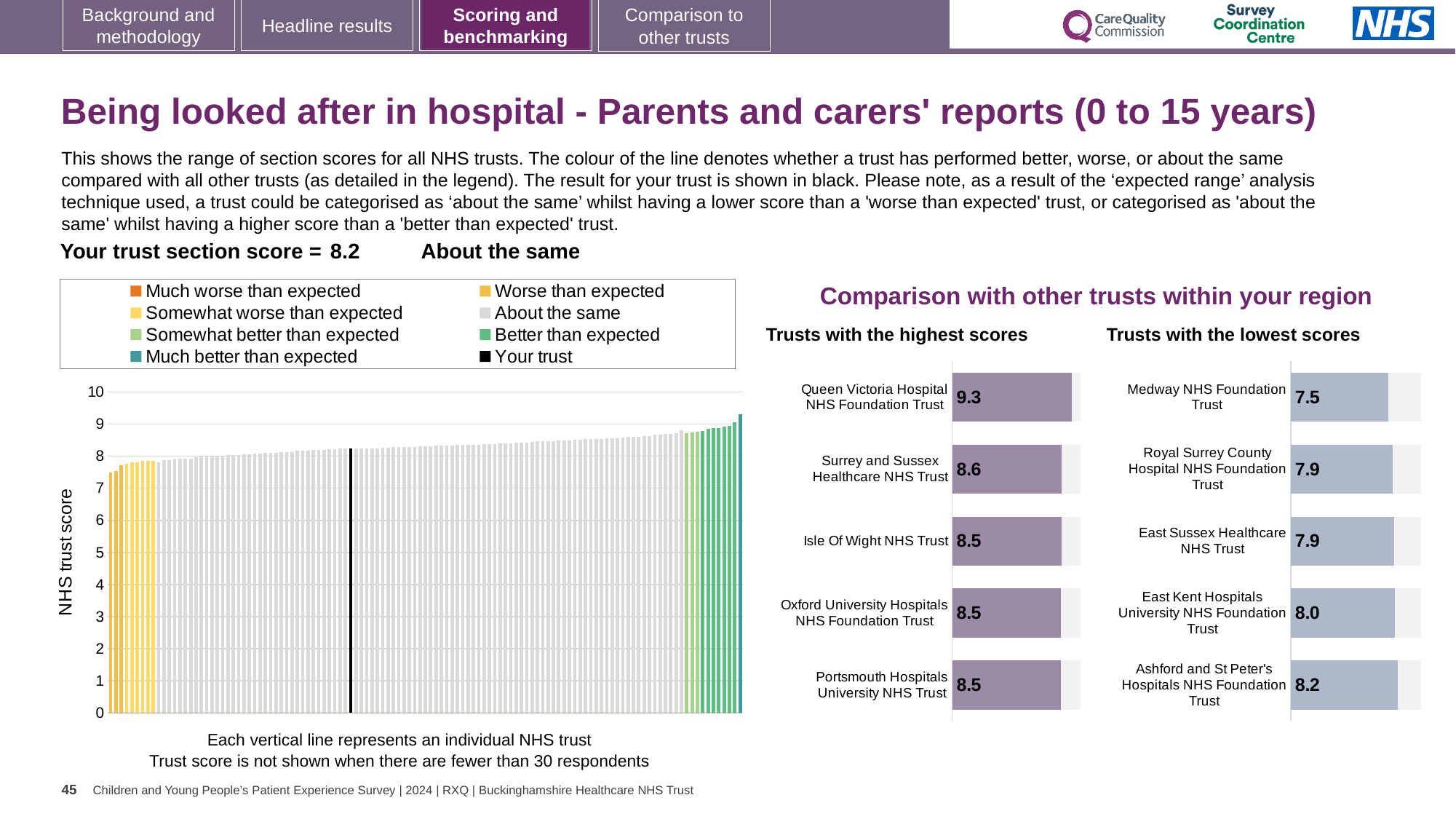
In the 'Trusts with the highest scores' chart, what is the score for Surrey and Sussex Healthcare NHS Trust? 8.6 In the 'Trusts with the highest scores' chart, which trust has the highest score? Queen Victoria Hospital NHS Foundation Trust In the 'Trusts with the highest scores' chart, what is the score for Queen Victoria Hospital NHS Foundation Trust? 9.3 How many trusts are shown in the 'Trusts with the lowest scores' chart? 5 In the 'Trusts with the lowest scores' chart, what is the score for Ashford and St Peter's Hospitals NHS Foundation Trust? 8.2 In the large chart on the left showing all NHS trusts, is the value of the leftmost (lowest) bar greater or less than 8? less In the 'Trusts with the lowest scores' chart, which has the larger score: Medway NHS Foundation Trust or East Kent Hospitals University NHS Foundation Trust? East Kent Hospitals University NHS Foundation Trust What kind of chart is the large chart on the left showing all NHS trusts? bar chart In the large chart on the left showing all NHS trusts, do the bar values rise or fall from left to right? rise In the 'Trusts with the lowest scores' chart, what is the score for Medway NHS Foundation Trust? 7.5 In the 'Trusts with the highest scores' chart, what is the difference between the scores of Queen Victoria Hospital NHS Foundation Trust and Surrey and Sussex Healthcare NHS Trust? 0.7 In the 'Trusts with the lowest scores' chart, which trust has the lowest score? Medway NHS Foundation Trust